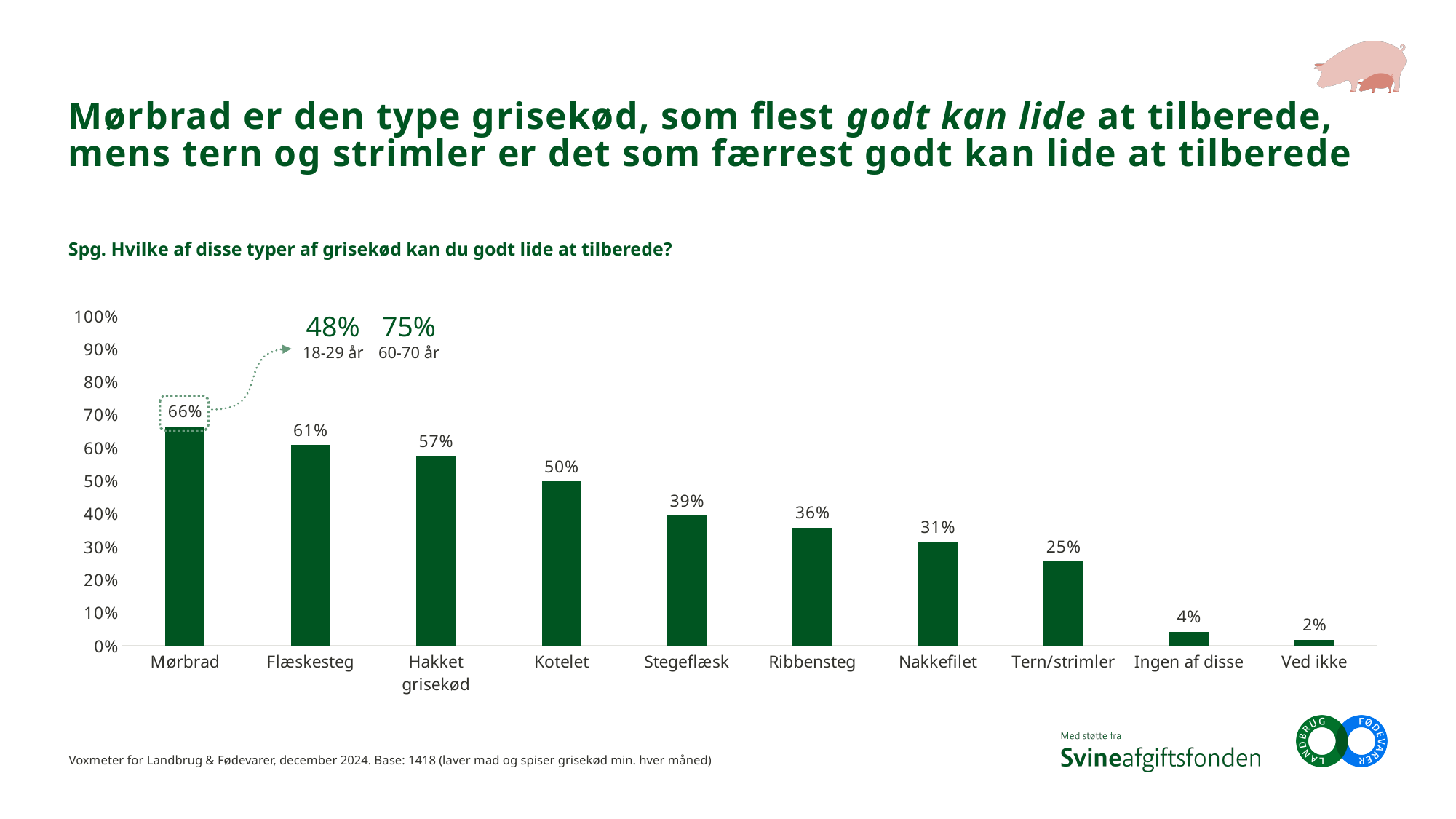
Which category has the highest value? Mørbrad According to the annotation, what is the value for Mørbrad among 60-70 år? 75% Which is larger, the value for Stegeflæsk or the value for Ribbensteg? Stegeflæsk What kind of chart is shown on the slide? Bar chart Do the values rise or fall from left to right along the x axis? Fall What is the value for Nakkefilet? 31% What is the value for Ved ikke? 2% What is the value for Kotelet? 50% What is the value for Mørbrad? 66% What is the difference between the values for Flæskesteg and Hakket grisekød? 4% Which category has the lowest value? Ved ikke How many categories are shown on the x axis? 10